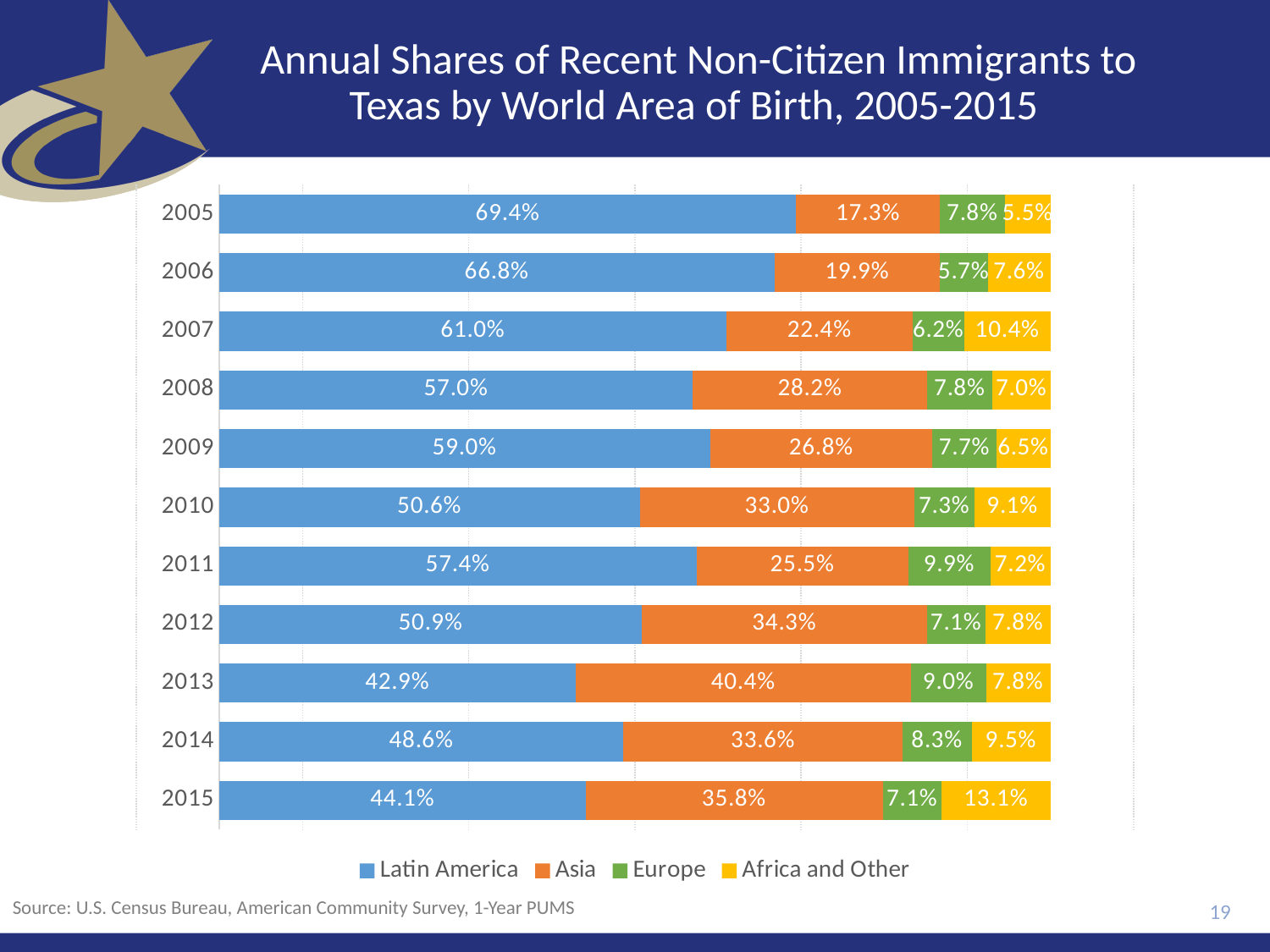
What is the Latin America share for 2005? 69.4% How many years are shown in the chart? 11 Which year has the lowest Latin America share? 2013 What is the Asia share for 2013? 40.4% What is the Europe share for 2011? 9.9% Which year has the highest Latin America share? 2005 Which is larger, the Asia share in 2012 or the Asia share in 2014? 2012 What is the Africa and Other share for 2015? 13.1% What kind of chart is shown on the slide? Stacked bar chart What is the difference between the Latin America share in 2005 and in 2015? 25.3% Which year has the highest Asia share? 2013 How many series does the legend list? 4